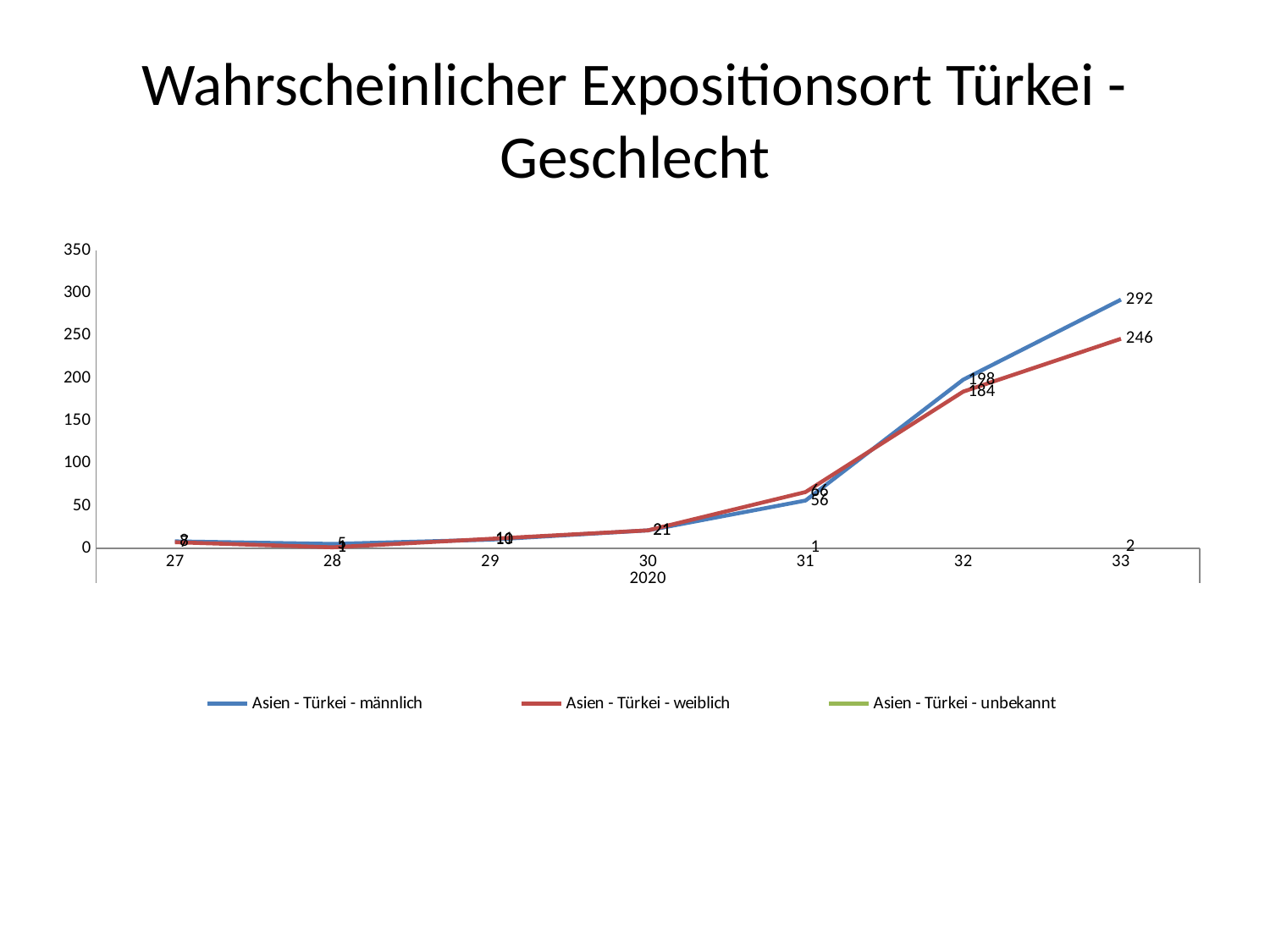
What is the value for Asien - Türkei - männlich at week 32? 198 What is the value for Asien - Türkei - weiblich at week 33? 246 How many series does the legend list? 3 Is the value for Asien - Türkei - weiblich at week 31 greater or less than 100? less What is the title of the chart? Wahrscheinlicher Expositionsort Türkei - Geschlecht What is the value for Asien - Türkei - weiblich at week 32? 184 Do the values for Asien - Türkei - männlich rise or fall from week 28 to week 33? rise At week 33, which series has the larger value, männlich or weiblich? Asien - Türkei - männlich What is the value for Asien - Türkei - männlich at week 33? 292 What is the difference between the männlich and weiblich values at week 33? 46 How many weeks are shown on the x axis? 7 What kind of chart is shown on the slide? line chart